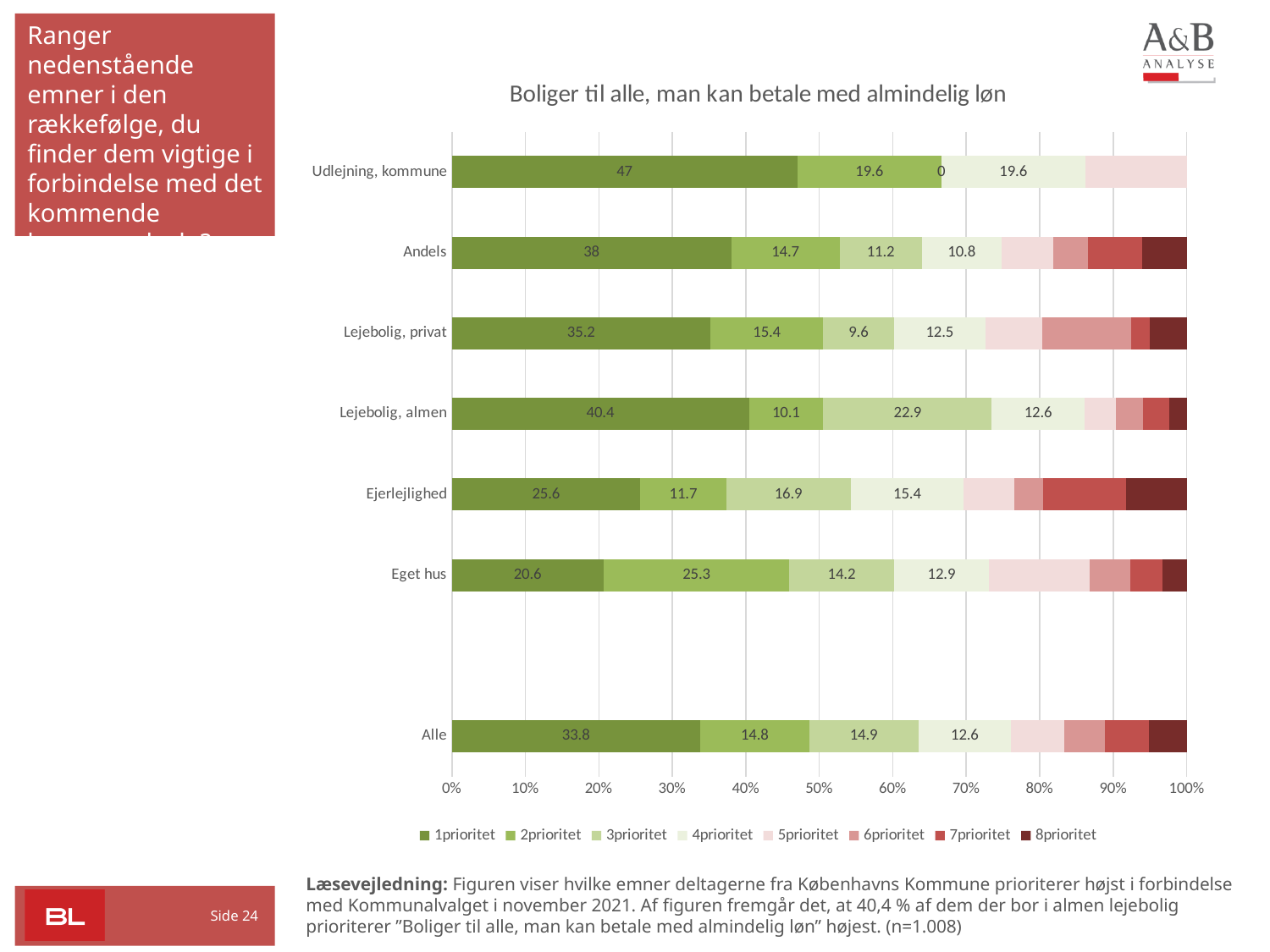
What is the 4prioritet value for Ejerlejlighed? 15.4 Which category has the highest 1prioritet value? Udlejning, kommune Which has the larger 3prioritet value, Lejebolig, almen or Ejerlejlighed? Lejebolig, almen What is the difference between the 1prioritet values for Andels and Lejebolig, privat? 2.8 What is the title of the chart? Boliger til alle, man kan betale med almindelig løn Which category has the lowest 1prioritet value? Eget hus What is the 1prioritet value for Lejebolig, almen? 40.4 How many series does the legend list? 8 How many categories (bars) are shown on the y axis of the chart? 7 What is the 2prioritet value for Eget hus? 25.3 What is the 1prioritet value for Alle? 33.8 What kind of chart is shown on the slide? bar chart